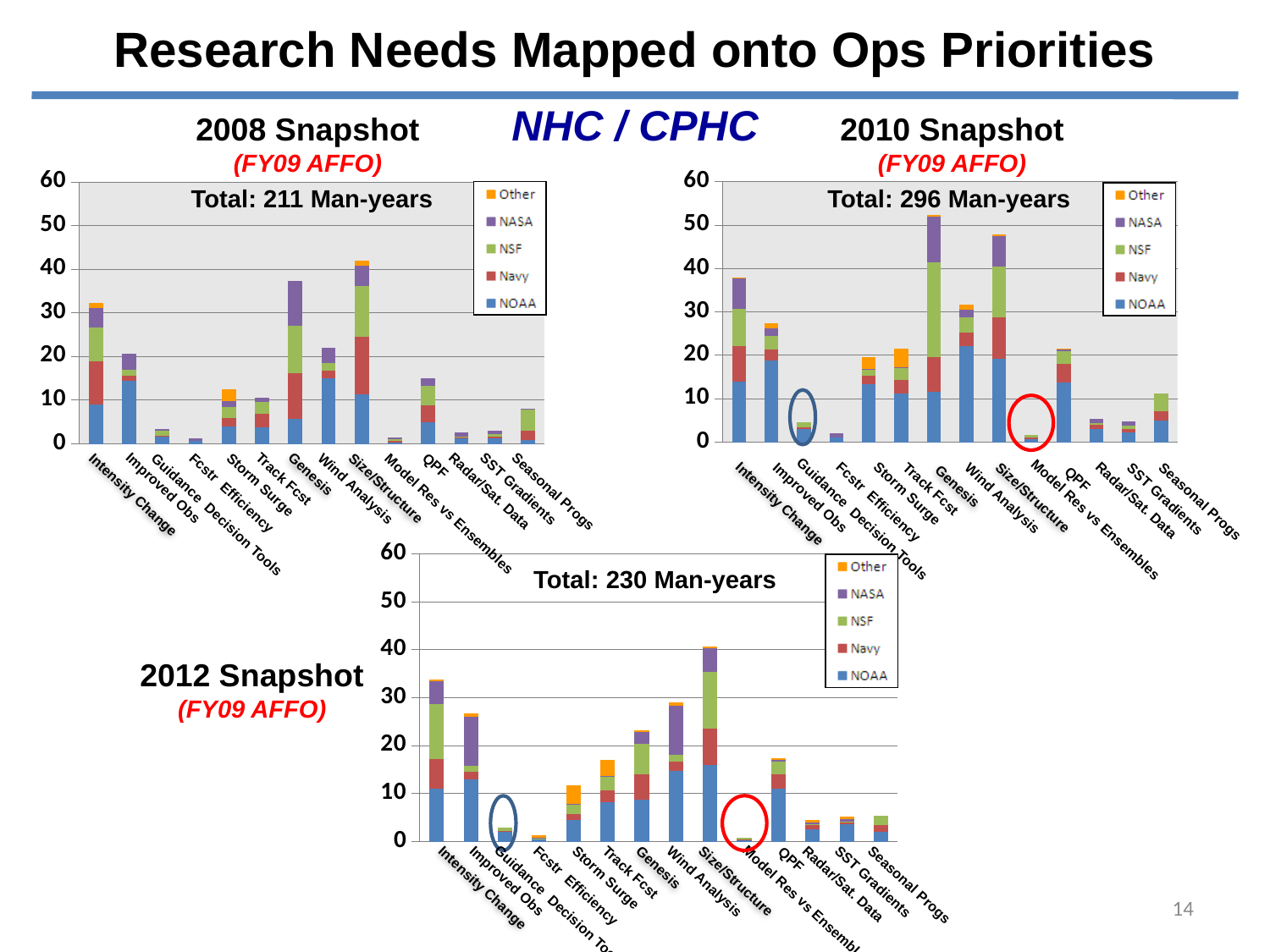
In the 2008 Snapshot chart, is the total bar for Size/Structure greater or less than 40? greater In the 2010 Snapshot chart, which category has the tallest stacked bar? Genesis In the 2008 Snapshot chart, which has the taller stacked bar, Genesis or Wind Analysis? Genesis How many series does the legend of the 2010 Snapshot chart list? 5 How many categories are shown on the x axis of the 2012 Snapshot chart? 14 In the 2008 Snapshot chart, which category has the tallest stacked bar? Size/Structure In the 2008 Snapshot chart, what total number of man-years is printed? 211 Man-years What type of chart is the 2008 Snapshot chart? stacked bar chart What is the difference between the total man-years printed on the 2010 Snapshot chart and the 2008 Snapshot chart? 85 Man-years In the 2012 Snapshot chart, what total number of man-years is printed? 230 Man-years In the 2012 Snapshot chart, which category has the tallest stacked bar? Size/Structure In the 2010 Snapshot chart, what total number of man-years is printed? 296 Man-years